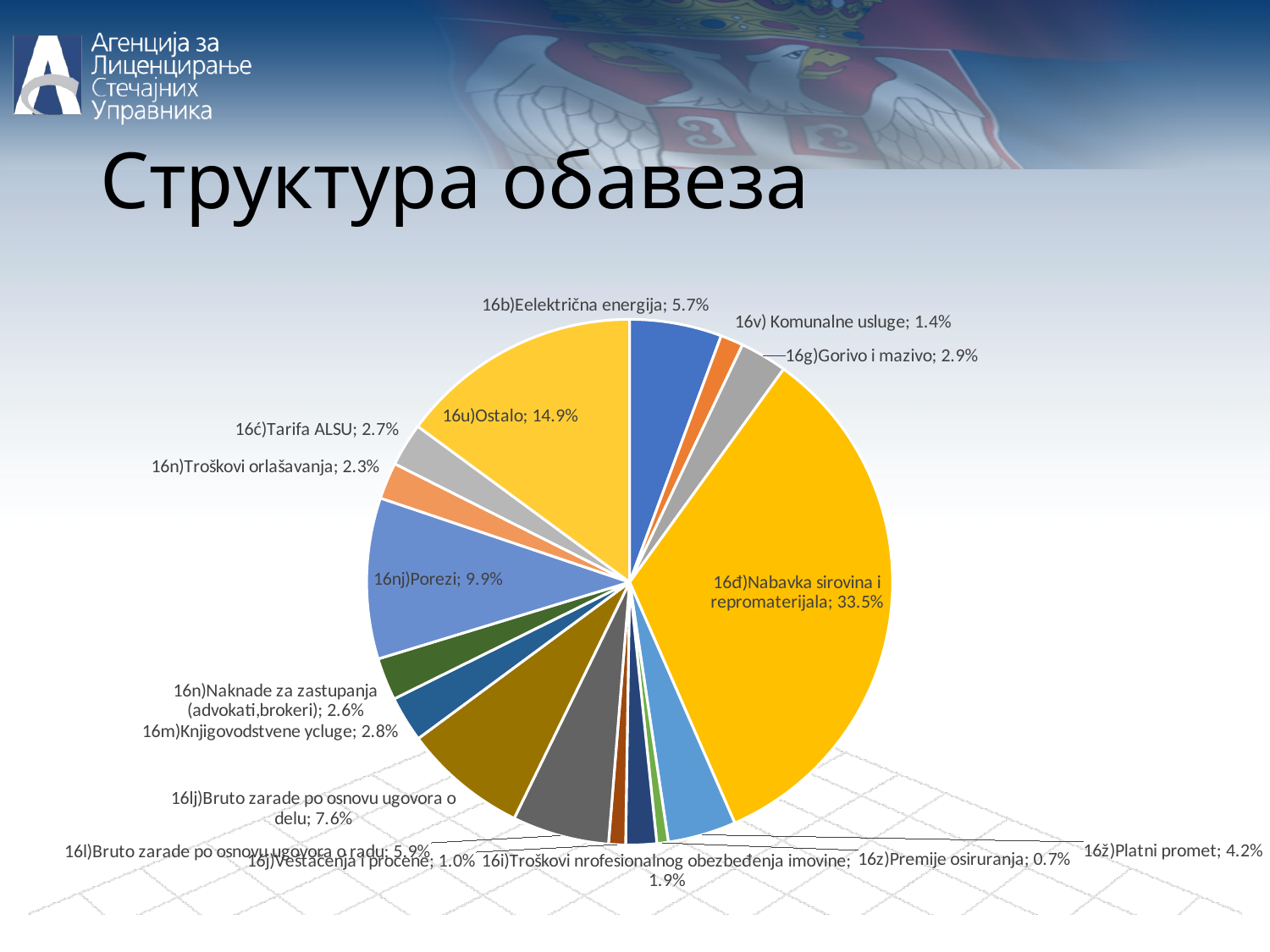
What is the title of the slide containing the pie chart? Структура обавеза What is the value shown for 16nj)Porezi? 9.9% What is the value shown for 16u)Ostalo? 14.9% What type of chart is shown on the slide? pie chart Which category has the smallest slice of the pie? 16z)Premije osiruranja Which category has the largest slice of the pie? 16đ)Nabavka sirovina i repromaterijala What is the value shown for 16ž)Platni promet? 4.2% What is the value shown for 16b)Eelektrična energija? 5.7% What share of the pie does 16đ)Nabavka sirovina i repromaterijala represent? 33.5% Which is larger, 16lj)Bruto zarade po osnovu ugovora o delu or 16l)Bruto zarade po osnovu ugovora o radu? 16lj)Bruto zarade po osnovu ugovora o delu What is the difference between the shares of 16u)Ostalo and 16nj)Porezi? 5.0% How many slices does the pie chart have? 16